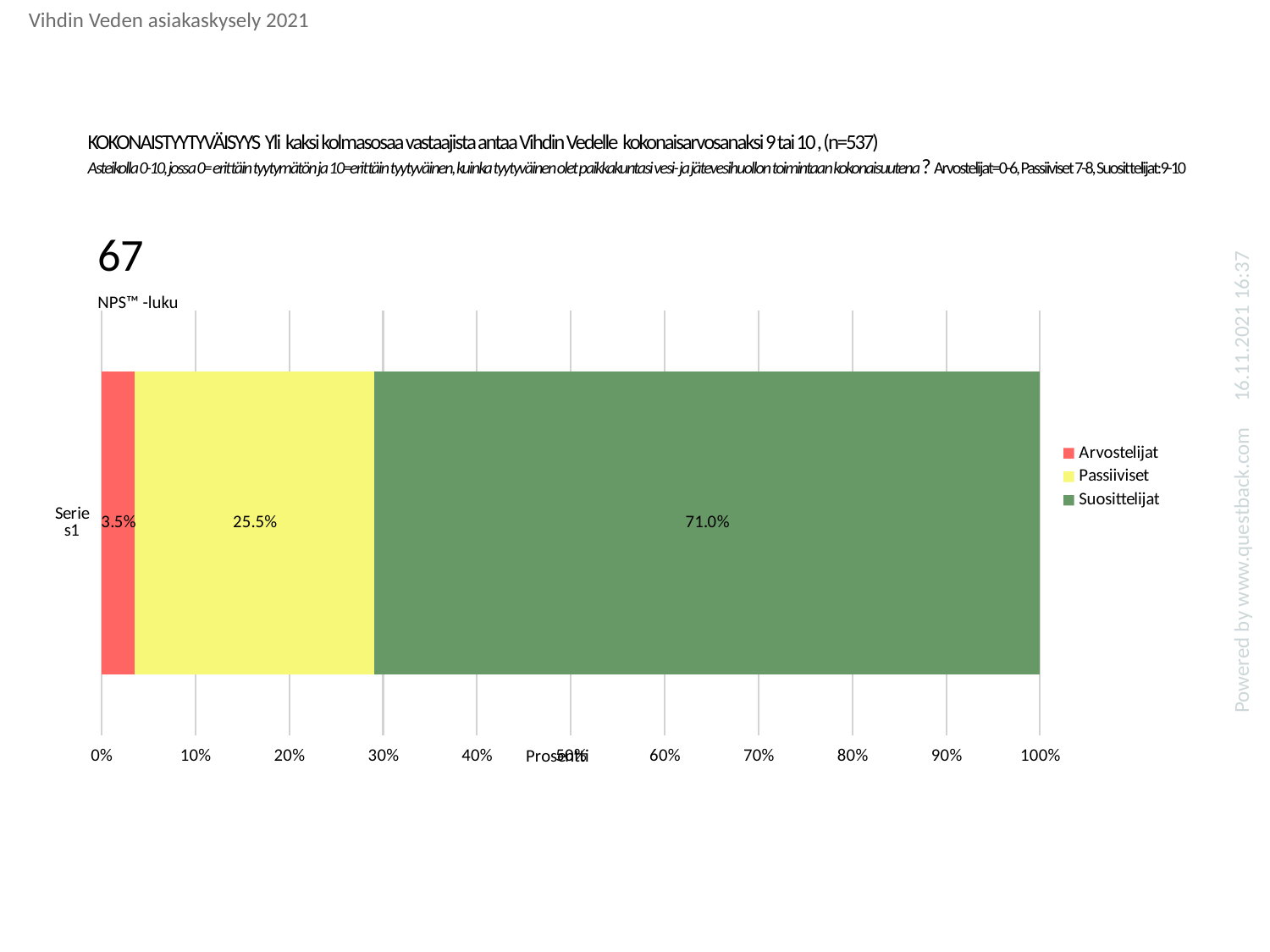
What kind of chart is shown on the slide? Stacked bar chart How many series does the legend list? 3 Which series has the largest share of the bar? Suosittelijat What NPS™ -luku value is shown above the chart? 67 What is the total of the stacked bar? 100.0% What is the difference between the Passiiviset and Arvostelijat values? 22.0% Which series has the smallest share of the bar? Arvostelijat What is the value for Passiiviset in the stacked bar? 25.5% Which is larger, the Passiiviset value or the Arvostelijat value? Passiiviset What is the value for Arvostelijat in the stacked bar? 3.5% What is the difference between the Suosittelijat and Passiiviset values? 45.5% What is the value for Suosittelijat in the stacked bar? 71.0%